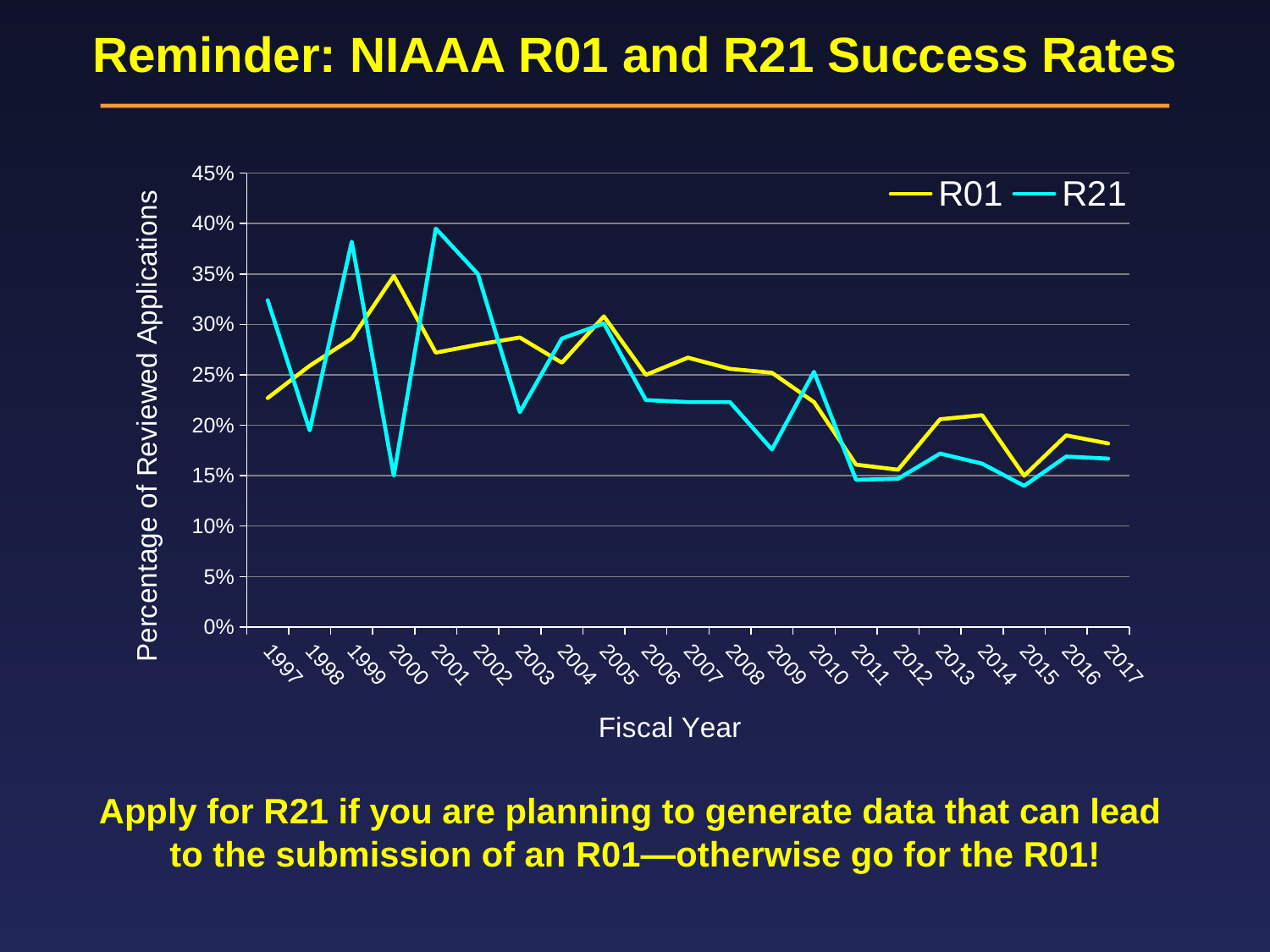
In which fiscal year does the R21 line reach its highest value? 2001 In 2013, which series has the higher success rate, R01 or R21? R01 Does the R01 success rate generally rise or fall from 2005 to 2017? fall What is the label on the y axis of the chart? Percentage of Reviewed Applications In 1999, which series has the higher success rate, R01 or R21? R21 Is the R01 value for 2011 greater or less than 20%? less What kind of chart is shown on the slide? Line chart Is the R21 value for 2000 greater or less than 20%? less Is the R21 value for 1999 greater or less than 35%? greater In which fiscal year does the R01 line reach its highest value? 2000 How many fiscal years are plotted along the x axis? 21 How many series does the legend list? 2